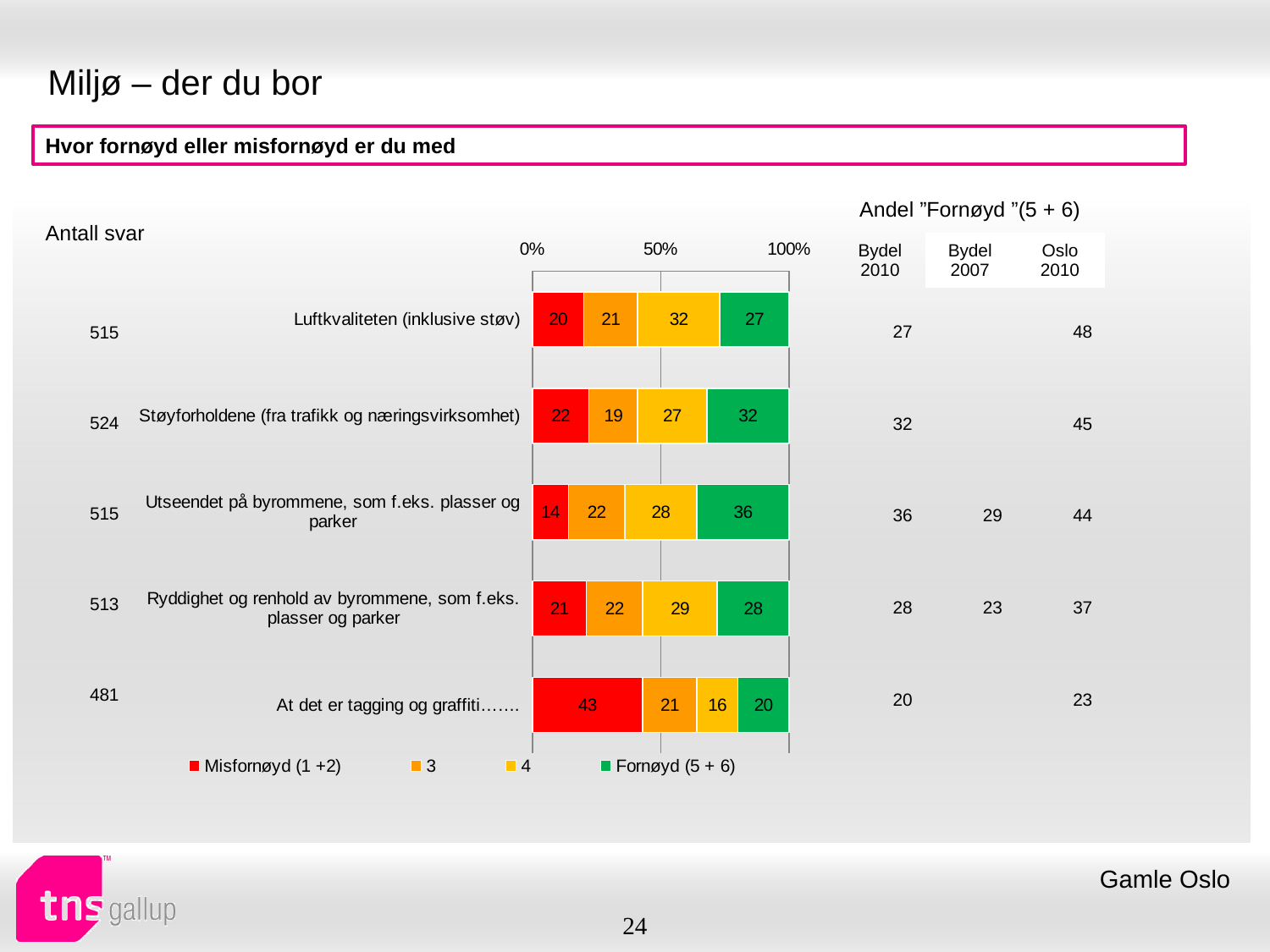
What kind of chart is shown on the slide? Stacked bar chart What is the value of the "Misfornøyd (1 +2)" segment for "At det er tagging og graffiti……."? 43 Which category has the lowest "Fornøyd (5 + 6)" value? At det er tagging og graffiti……. Which category has the lowest "Misfornøyd (1 +2)" value? Utseendet på byrommene, som f.eks. plasser og parker What is the value of the "4" segment for "Ryddighet og renhold av byrommene, som f.eks. plasser og parker"? 29 Which is larger: the "Fornøyd (5 + 6)" value for "Støyforholdene (fra trafikk og næringsvirksomhet)" or for "Ryddighet og renhold av byrommene, som f.eks. plasser og parker"? Støyforholdene (fra trafikk og næringsvirksomhet) What is the value of the "Fornøyd (5 + 6)" segment for "Luftkvaliteten (inklusive støv)"? 27 How many categories are shown in the chart? 5 What is the difference between the "Misfornøyd (1 +2)" value for "At det er tagging og graffiti……." and for "Luftkvaliteten (inklusive støv)"? 23 How many series does the legend list? 4 Which category has the highest "Fornøyd (5 + 6)" value? Utseendet på byrommene, som f.eks. plasser og parker What is the total of the stacked bar for "Støyforholdene (fra trafikk og næringsvirksomhet)"? 100